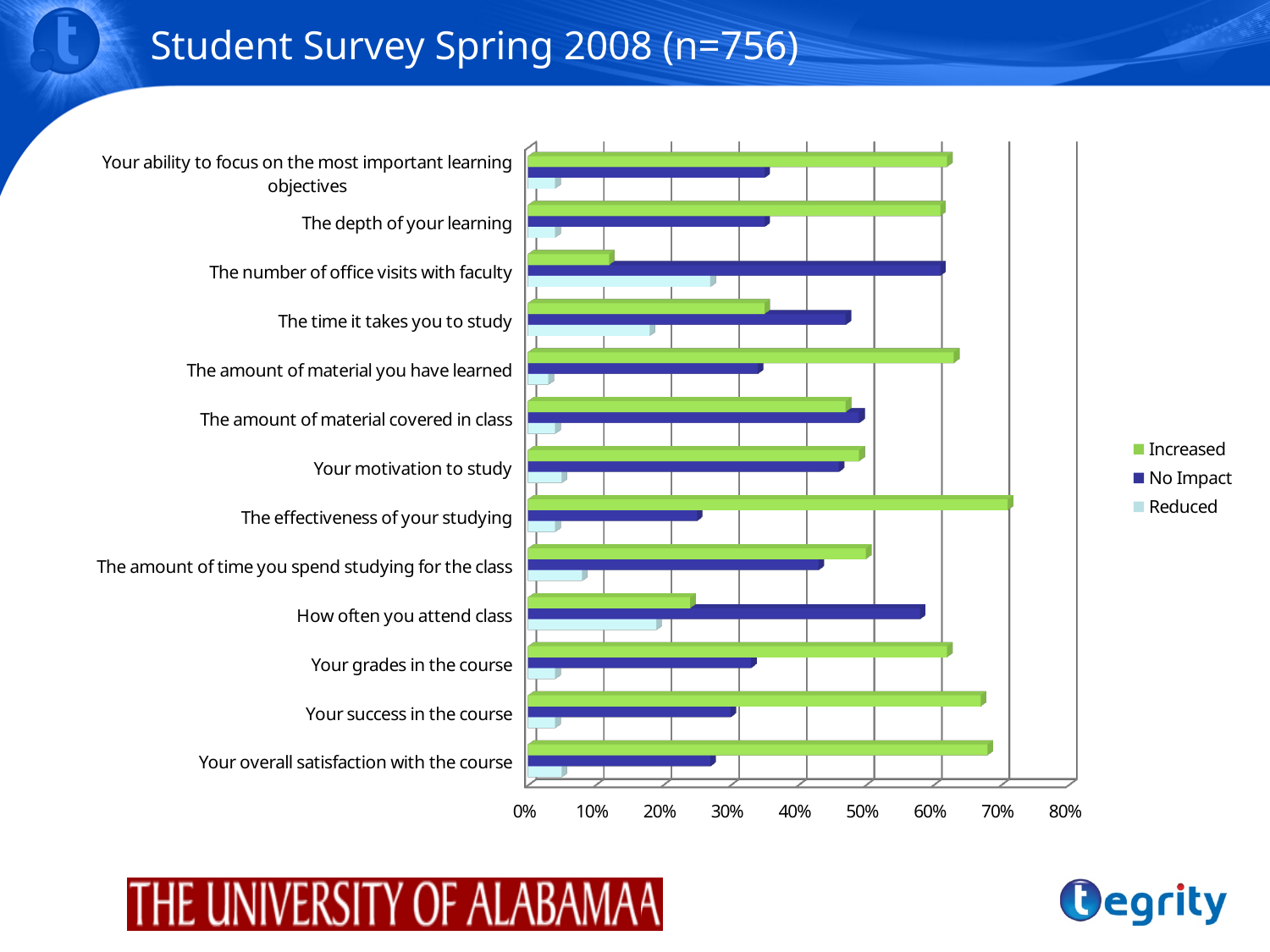
For 'How often you attend class', which is larger: the 'Increased' value or the 'No Impact' value? No Impact Which survey item has the lowest 'Increased' value? The number of office visits with faculty How many survey items (categories) are plotted on the chart? 13 Which survey item has the highest 'Reduced' value? The number of office visits with faculty Which survey item has the highest 'Increased' value? The effectiveness of your studying Is the 'Reduced' value for 'The time it takes you to study' greater or less than 10%? greater What is the title of the slide containing the chart? Student Survey Spring 2008 (n=756) How many series does the legend list? 3 Is the 'Increased' value for 'The effectiveness of your studying' greater or less than 60%? greater Is the 'No Impact' value for 'How often you attend class' greater or less than 50%? greater What kind of chart is shown on the slide? bar chart